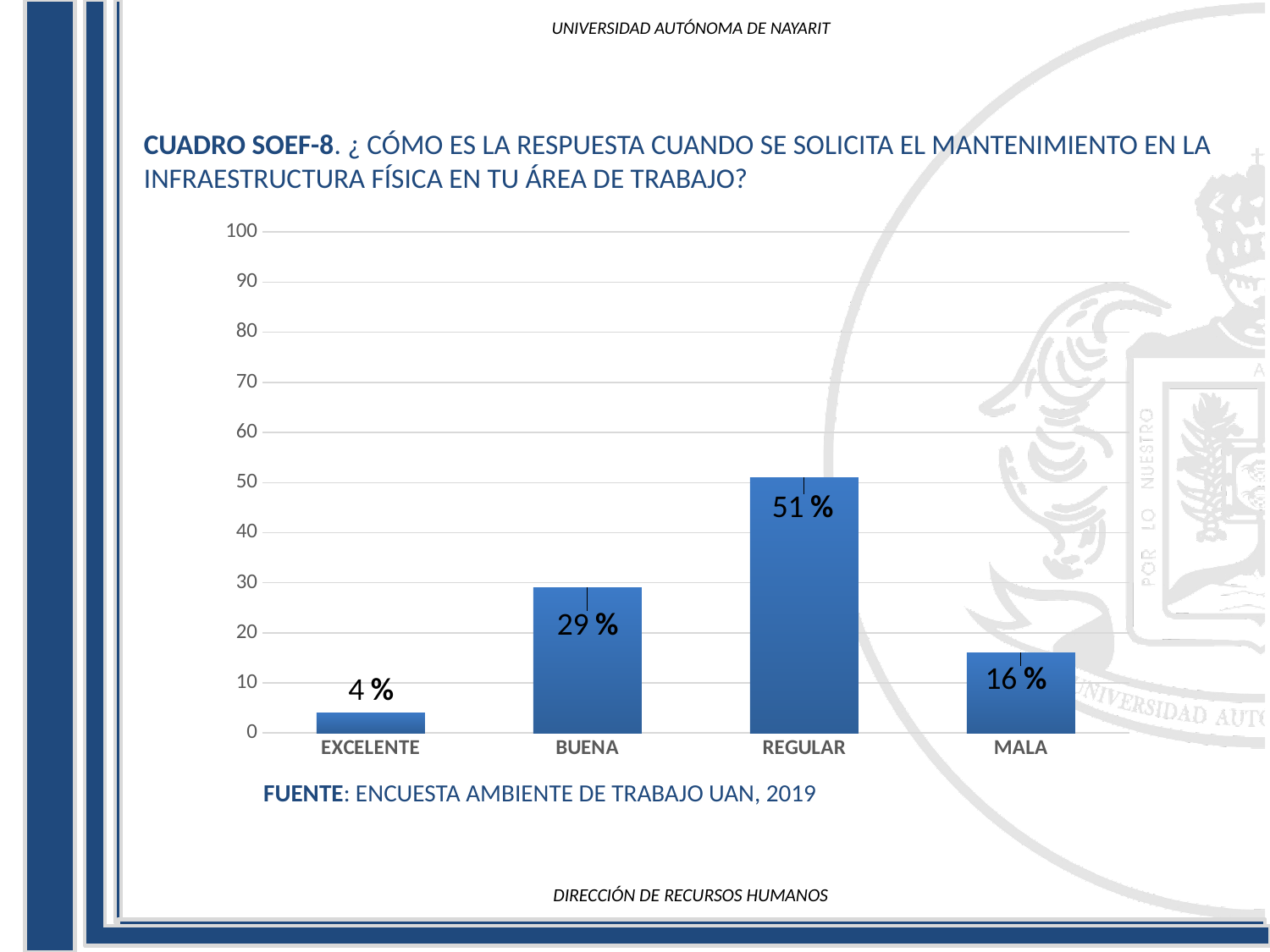
What is the value for MALA? 16 % What is the value for REGULAR? 51 % What is the value for BUENA? 29 % Which is larger, the value for BUENA or the value for MALA? BUENA How many categories are shown on the x axis? 4 Which category has the highest value? REGULAR What kind of chart is shown on the slide? bar chart What is the difference between the values for REGULAR and BUENA? 22 % What is the difference between the values for MALA and EXCELENTE? 12 % Which category has the lowest value? EXCELENTE What is the value for EXCELENTE? 4 % Is the value for REGULAR greater or less than 50? greater